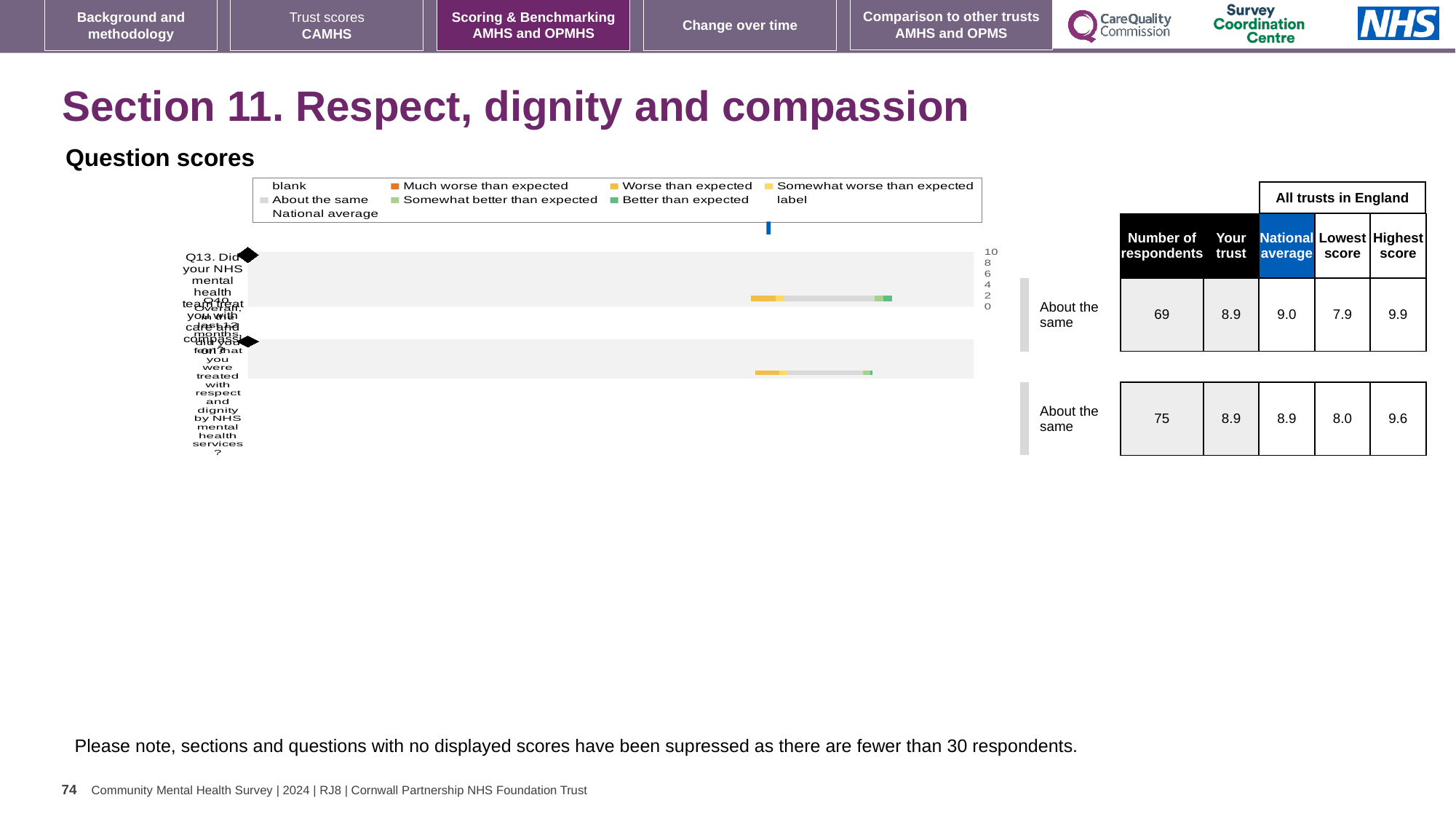
In the chart legend, what colour represents 'Better than expected'? green What is the highest tick value shown on the chart's axis? 10 In the table beside the chart, what is the lowest score for the bottom row (Q10)? 8.0 What kind of chart is used to show the question scores on this slide? bar chart How many question rows are plotted in the question scores chart? 2 In the table beside the chart, what is the national average for the top row (Q13)? 9.0 What is the difference between the highest score and the lowest score for the top row (Q13)? 2.0 In the table beside the chart, what is the highest score for the bottom row (Q10)? 9.6 Which row has the higher national average, the top row (Q13) or the bottom row (Q10)? Q13 In the table beside the chart, what is the 'Your trust' score for the top row (Q13)? 8.9 In the table beside the chart, how many respondents are listed for the top row (Q13)? 69 What benchmark category label is shown next to the bottom row (Q10) of the chart? About the same